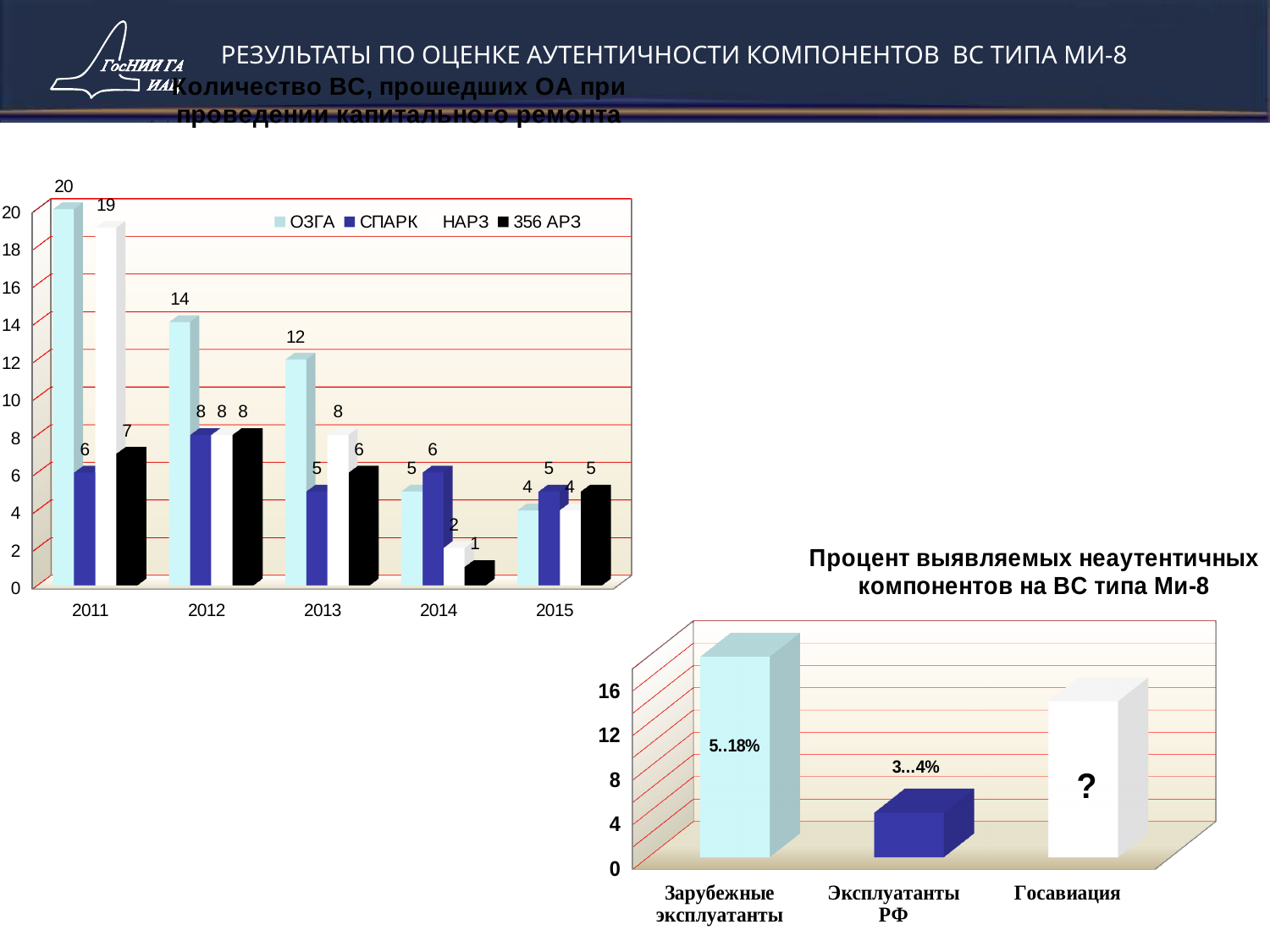
In the left chart (Количество ВС, прошедших ОА при проведении капитального ремонта), which year has the highest value for ОЗГА? 2011 In the left chart (Количество ВС, прошедших ОА при проведении капитального ремонта), what is the value for 356 АРЗ in 2013? 6 In the right chart (Процент выявляемых неаутентичных компонентов на ВС типа Ми-8), what label is printed on the bar for Эксплуатанты РФ? 3...4% In the left chart (Количество ВС, прошедших ОА при проведении капитального ремонта), which is larger in 2014: the value for ОЗГА or the value for 356 АРЗ? ОЗГА In the left chart (Количество ВС, прошедших ОА при проведении капитального ремонта), how many series does the legend list? 4 In the left chart (Количество ВС, прошедших ОА при проведении капитального ремонта), how many years are shown on the x axis? 5 In the left chart (Количество ВС, прошедших ОА при проведении капитального ремонта), do the ОЗГА values rise or fall from 2011 to 2015? fall In the left chart (Количество ВС, прошедших ОА при проведении капитального ремонта), what is the value for НАРЗ in 2014? 2 In the left chart (Количество ВС, прошедших ОА при проведении капитального ремонта), what is the value for ОЗГА in 2011? 20 In the left chart (Количество ВС, прошедших ОА при проведении капитального ремонта), what is the difference between the ОЗГА value in 2011 and the ОЗГА value in 2012? 6 In the right chart (Процент выявляемых неаутентичных компонентов на ВС типа Ми-8), which category has the tallest bar? Зарубежные эксплуатанты In the left chart (Количество ВС, прошедших ОА при проведении капитального ремонта), which year has the lowest value for 356 АРЗ? 2014